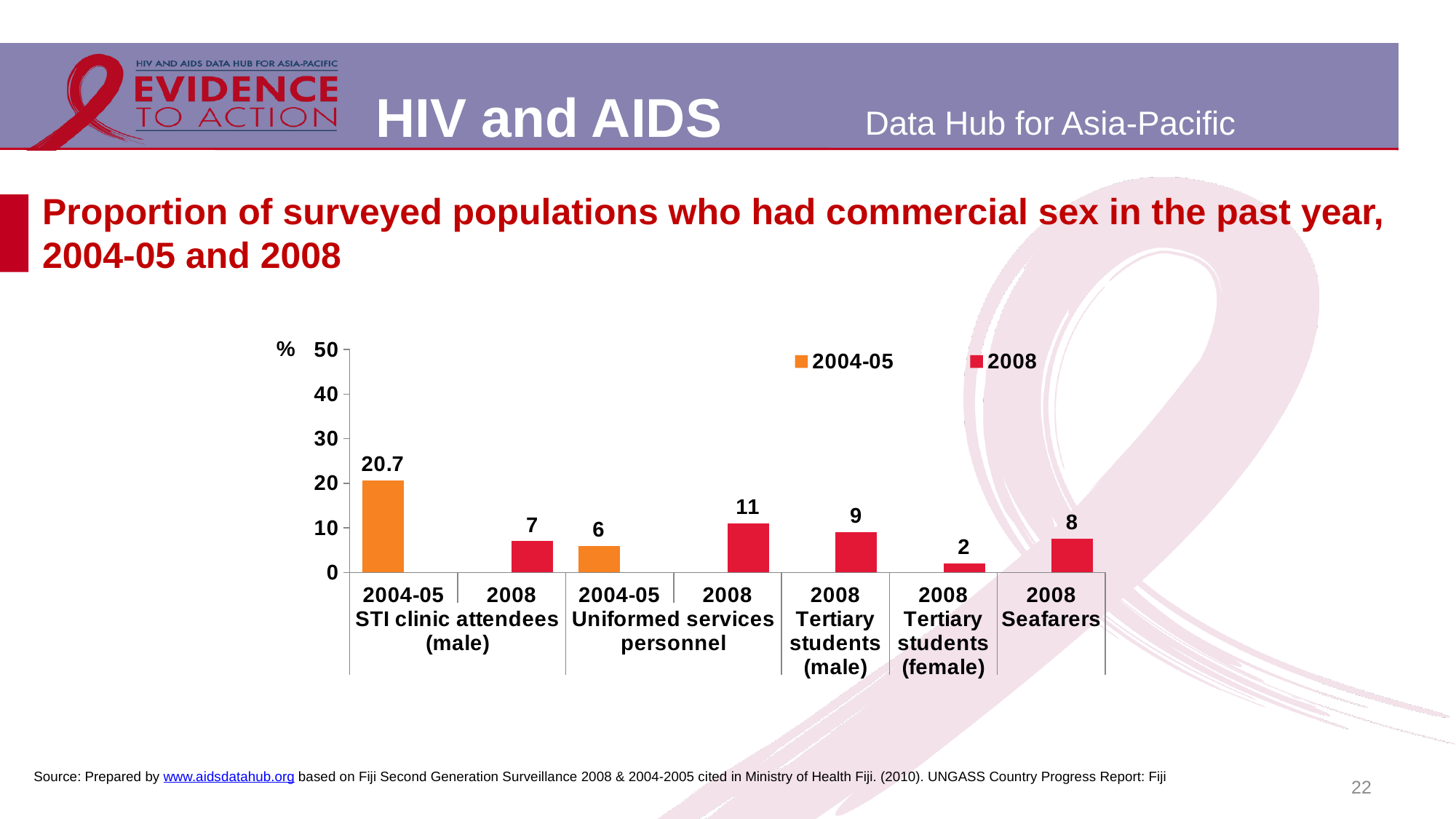
Which colour represents the 2008 series in the legend? Red What is the value for Seafarers in 2008? 8 Which bar has the lowest value? Tertiary students (female), 2008 What is the value for Uniformed services personnel in 2008? 11 What kind of chart is shown on the slide? Bar chart What is the value for Tertiary students (female) in 2008? 2 Which is larger: the 2008 value for Tertiary students (male) or the 2008 value for Seafarers? Tertiary students (male) What is the value for STI clinic attendees (male) in 2004-05? 20.7 What is the difference between the 2004-05 and 2008 values for Uniformed services personnel? 5 Which bar has the highest value? STI clinic attendees (male), 2004-05 How many series does the legend list? 2 What is the value for STI clinic attendees (male) in 2008? 7